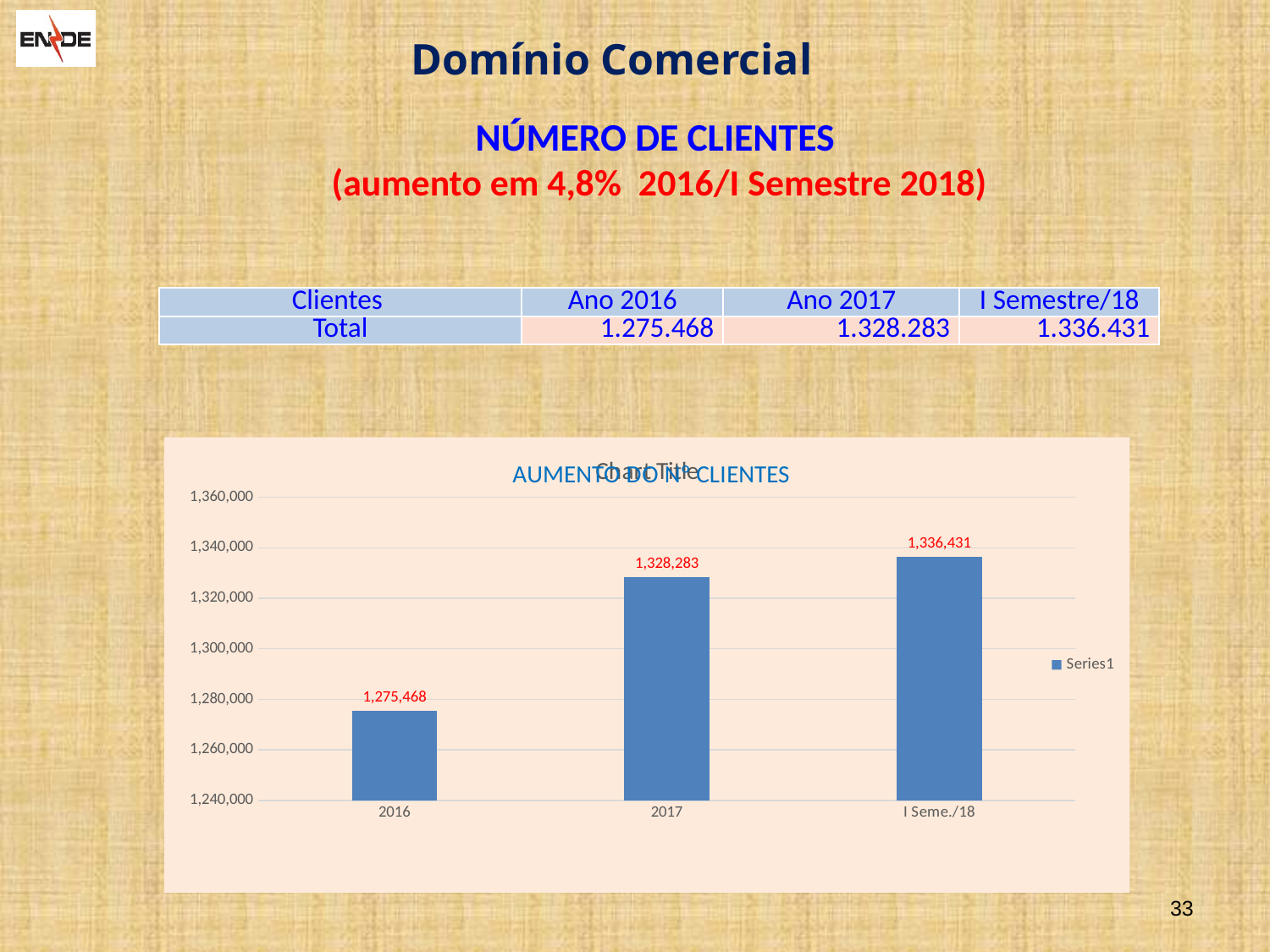
Do the values in the bar chart rise or fall from 2016 to I Seme./18? rise What is the value for 2017 in the bar chart? 1,328,283 What is the value for 2016 in the bar chart? 1,275,468 Which category has the lowest value in the bar chart? 2016 What kind of chart is shown on the slide? bar chart Is the value for 2016 in the bar chart greater or less than 1,280,000? less What is the difference between the values for 2017 and 2016 in the bar chart? 52,815 What is the difference between the values for I Seme./18 and 2017 in the bar chart? 8,148 How many bars are shown in the bar chart? 3 What is the value for I Seme./18 in the bar chart? 1,336,431 Which category has the highest value in the bar chart? I Seme./18 Which is larger in the bar chart, the value for 2017 or the value for I Seme./18? I Seme./18